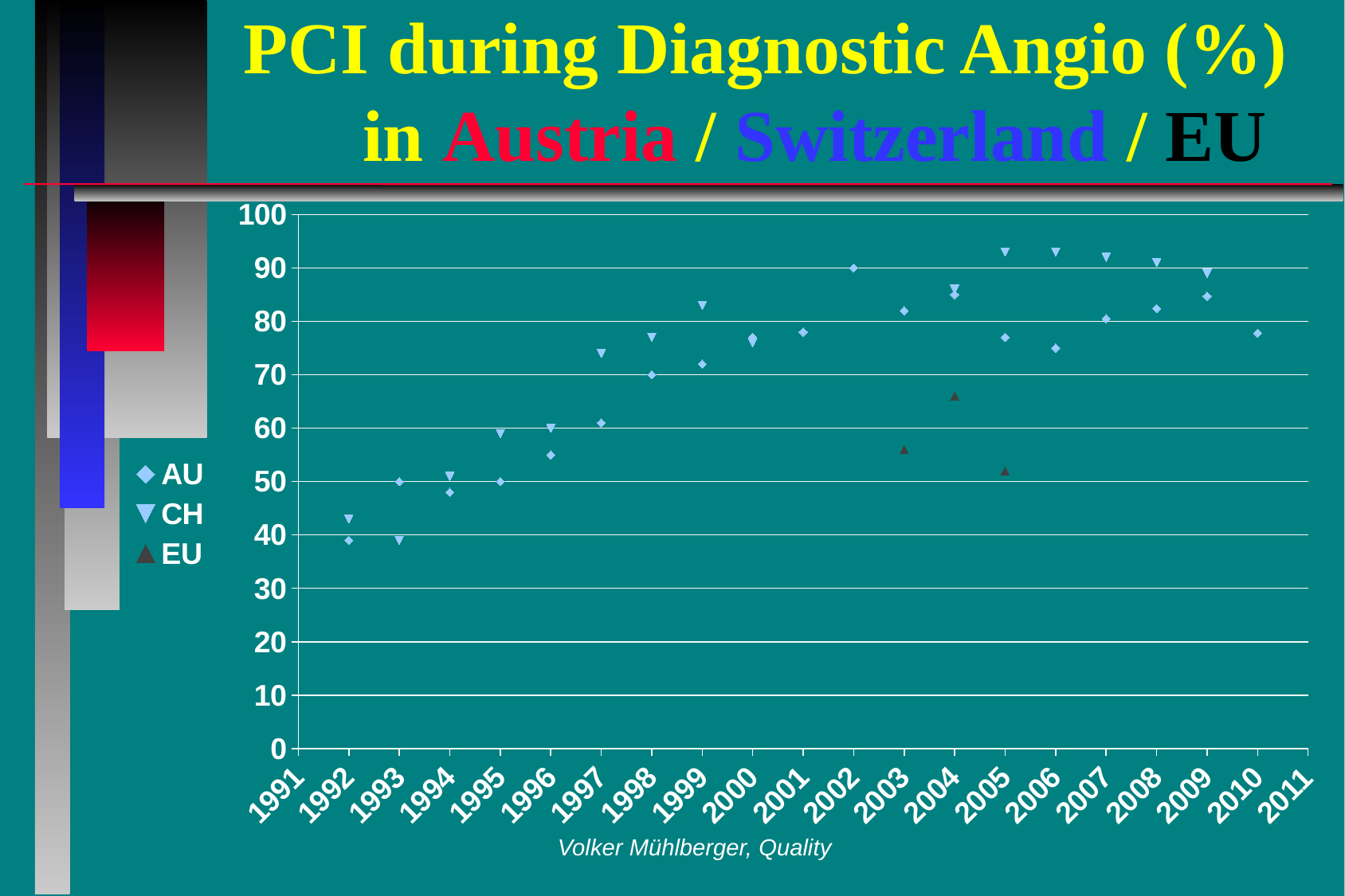
How many series does the legend list? 3 Which series are listed in the legend? AU, CH, EU What kind of chart is shown on the slide? scatter chart Is the value for CH in 2005 greater or less than 90? greater In which year does the EU series reach its highest value? 2004 How many data points are plotted for the EU series? 3 Is the value for AU in 2002 greater or less than 80? greater Do the AU values generally rise or fall from 1992 to 2002? rise Is the value for EU in 2004 greater or less than 60? greater Which series has the higher value in 2006, AU or CH? CH